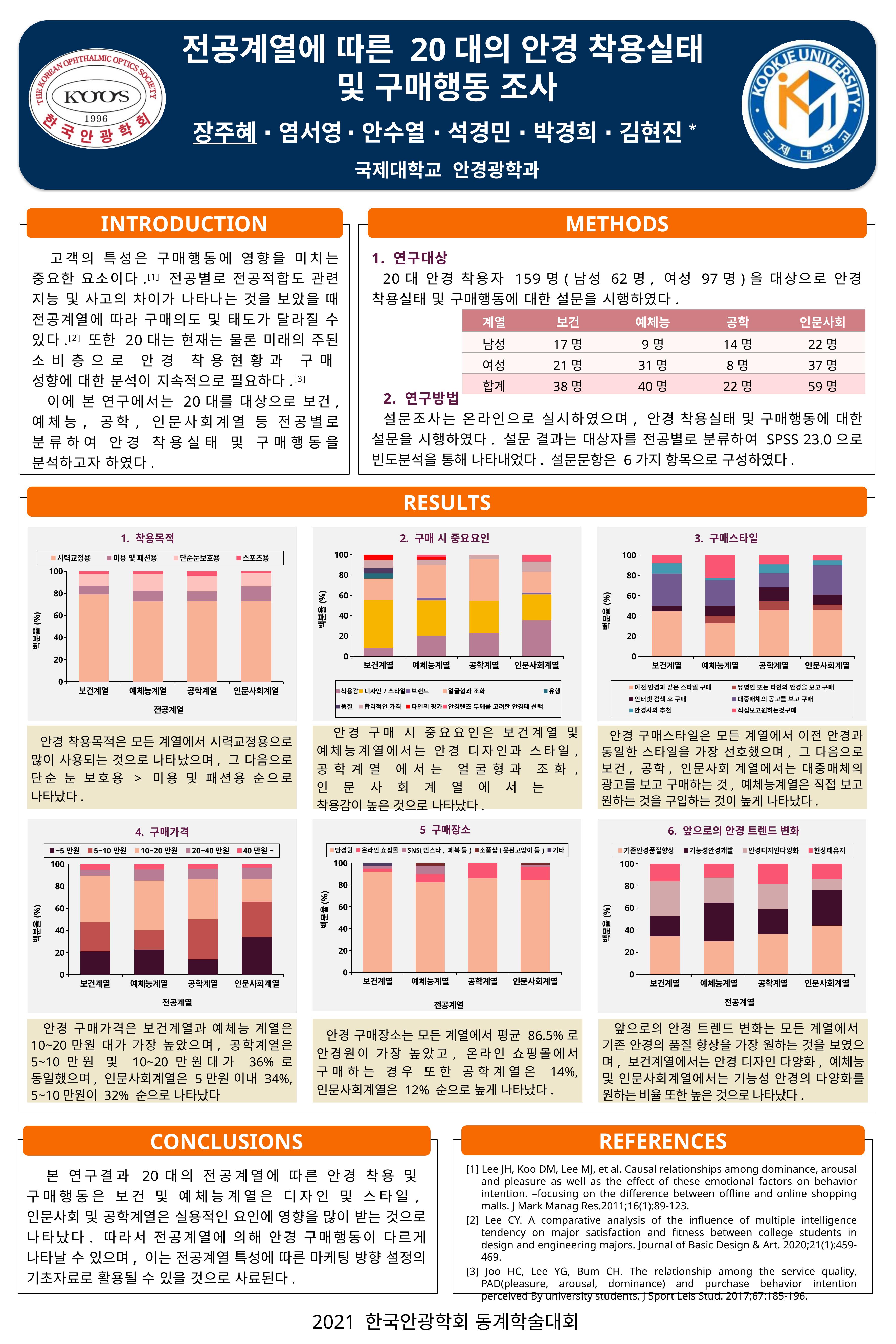
In the chart titled '4. 구매가격', how many series does the legend list? 5 In the chart titled '6. 앞으로의 안경 트렌드 변화', is the value of 기존안경품질향상 for 예체능계열 greater or less than 40? less In the chart titled '4. 구매가격', is the value of ~5 만원 for 인문사회계열 greater or less than 20? greater What kind of chart is the chart titled '1. 착용목적'? Stacked bar chart In the chart titled '1. 착용목적', how many series does the legend list? 4 In the chart titled '3. 구매스타일', is the value of 이전 안경과 같은 스타일 구매 for 예체능계열 greater or less than 40? less In the chart titled '2. 구매 시 중요요인', how many series does the legend list? 9 What is the x-axis label of the chart titled '4. 구매가격'? 전공계열 In the chart titled '1. 착용목적', how many categories are shown on the x axis? 4